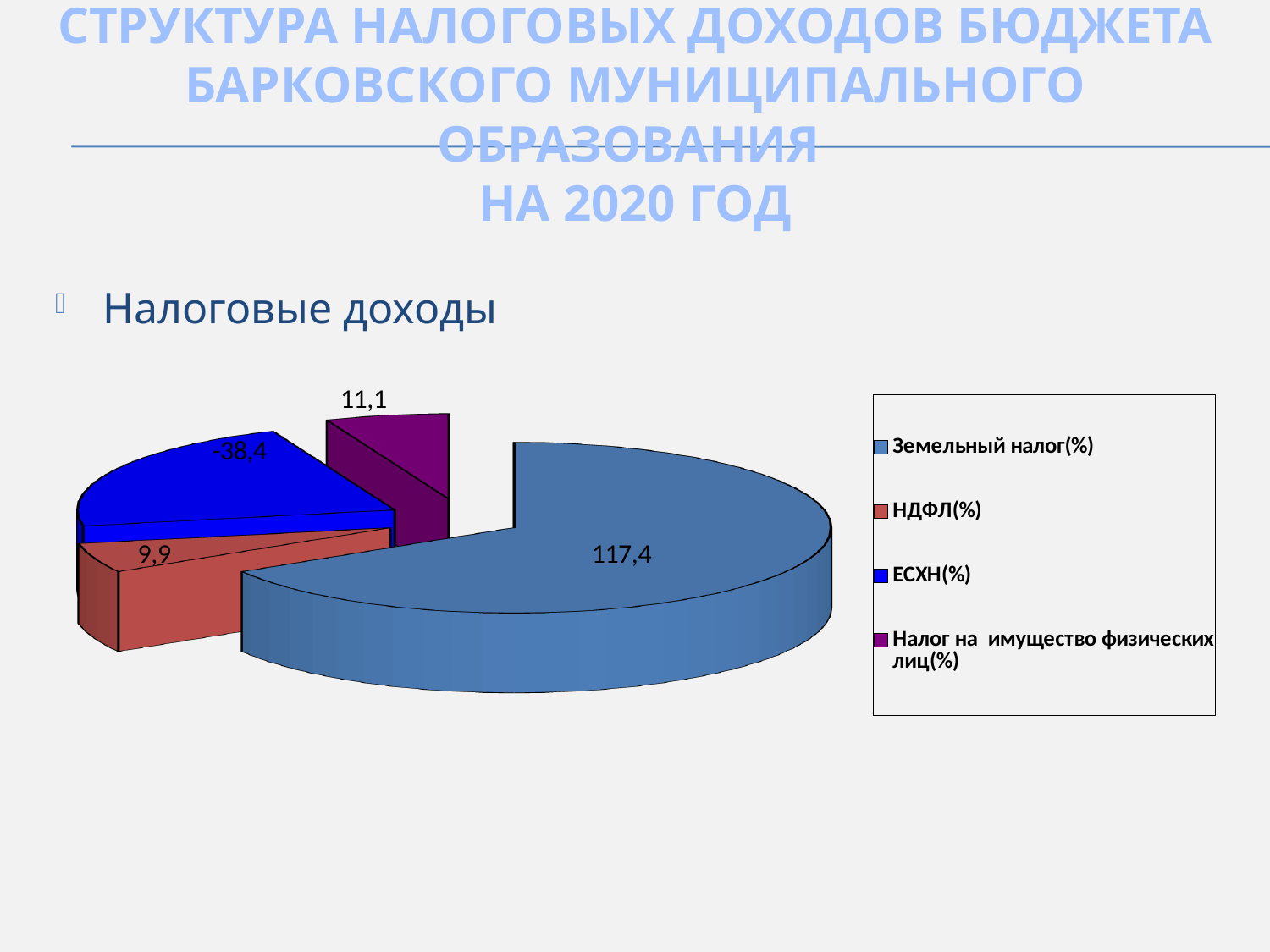
Which is larger, the value for НДФЛ(%) or the value for Налог на имущество физических лиц(%)? Налог на имущество физических лиц(%) What kind of chart is shown on the slide? Pie chart How many slices does the pie chart have? 4 What value is shown for ЕСХН(%) on the pie chart? -38,4 What is the difference between the values for Земельный налог(%) and Налог на имущество физических лиц(%)? 106,3 What colour is the slice for ЕСХН(%) on the pie chart? Blue Which category has the lowest value on the pie chart? ЕСХН(%) Which category has the highest value on the pie chart? Земельный налог(%) What value is shown for НДФЛ(%) on the pie chart? 9,9 What is the difference between the values for Налог на имущество физических лиц(%) and НДФЛ(%)? 1,2 What value is shown for Налог на имущество физических лиц(%) on the pie chart? 11,1 What value is shown for Земельный налог(%) on the pie chart? 117,4